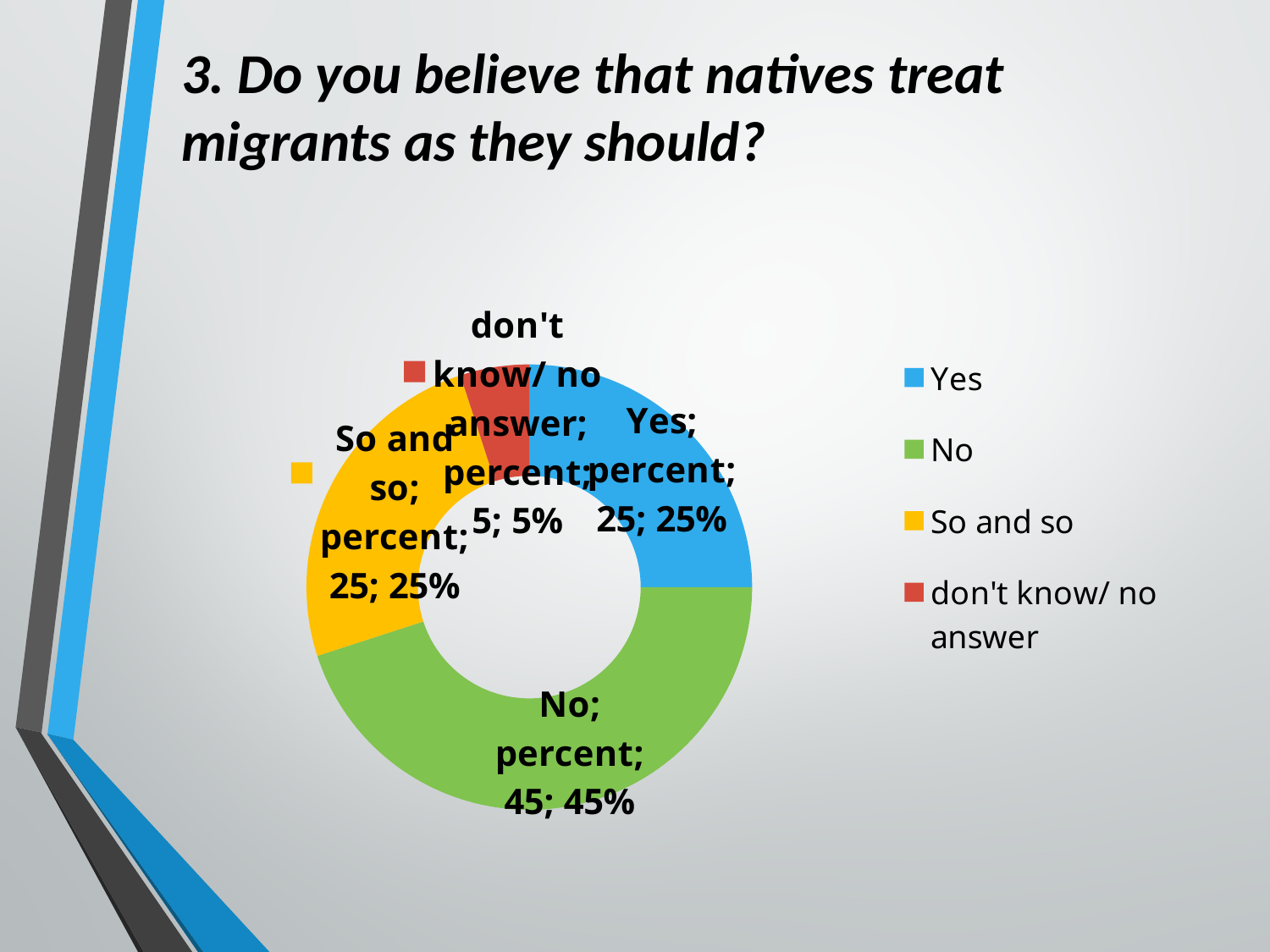
What percentage of respondents answered "So and so"? 25% What kind of chart is shown on the slide? doughnut chart What is the difference in percentage points between the "No" and "Yes" shares? 20 How many answer categories does the chart show? 4 What is the title of the question shown above the chart? 3. Do you believe that natives treat migrants as they should? Which answer category has the largest share of the chart? No What percentage of respondents answered "No"? 45% What colour is the "No" segment of the chart? green What percentage of respondents answered "Yes"? 25% What percentage of respondents answered "don't know/ no answer"? 5% Which is larger, the share for "No" or the share for "So and so"? No Which answer category has the smallest share of the chart? don't know/ no answer